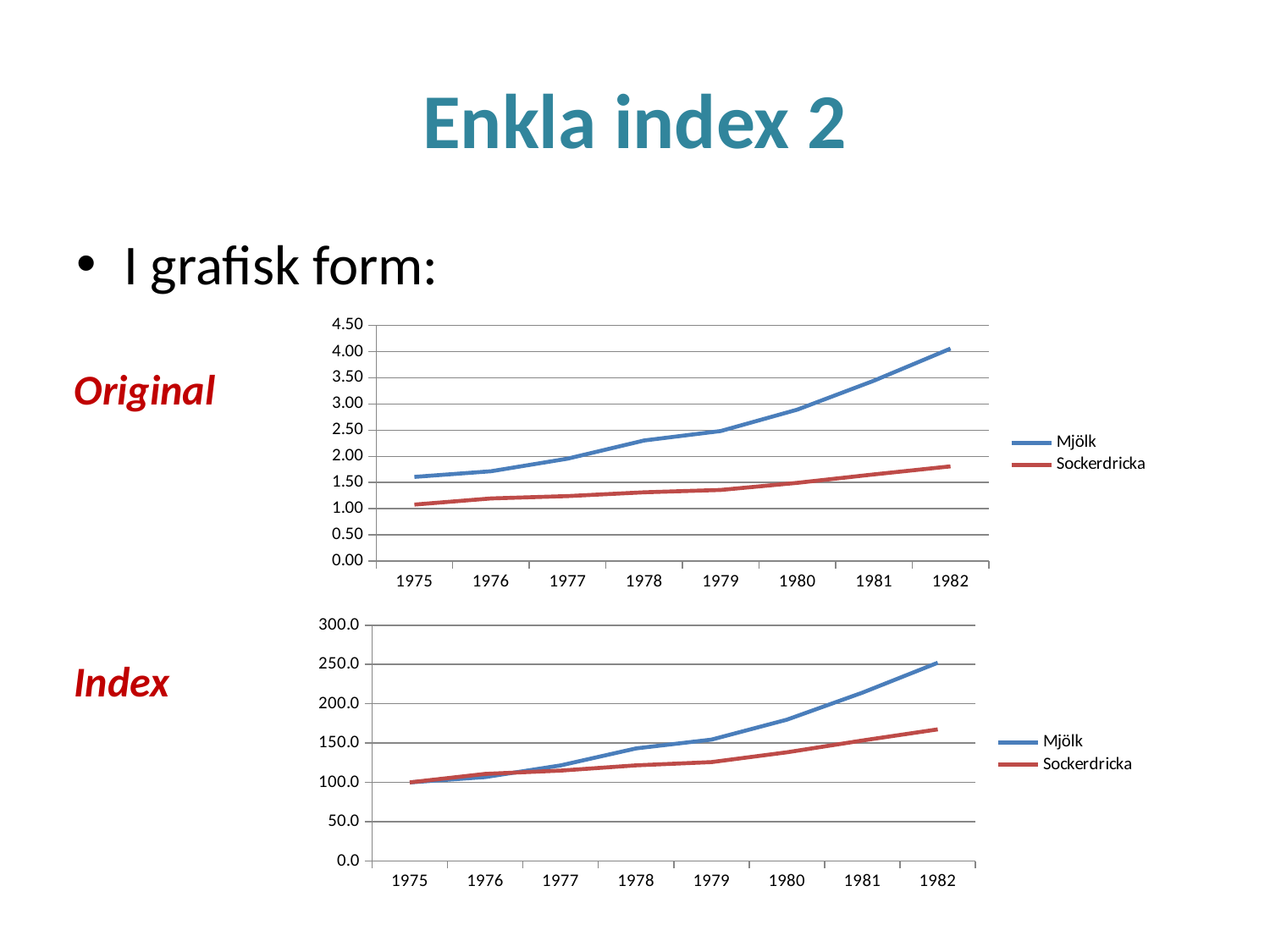
In the top chart (Original), which series has the higher value in 1982? Mjölk In the top chart (Original), does the Mjölk line rise or fall from 1975 to 1982? rise In the top chart (Original), is the value for Sockerdricka in 1982 greater or less than 2.00? less How many series does the legend of the bottom chart (Index) list? 2 In the bottom chart (Index), in which year is the Mjölk index highest? 1982 What kind of chart is the top chart (Original)? line chart In the bottom chart (Index), is the value for Sockerdricka in 1982 greater or less than 200.0? less In the bottom chart (Index), what is the index value for Mjölk in 1975? 100.0 How many years are shown on the x axis of the top chart (Original)? 8 Which series is drawn in blue in the bottom chart (Index)? Mjölk In the bottom chart (Index), is the value for Mjölk in 1982 greater or less than 200.0? greater